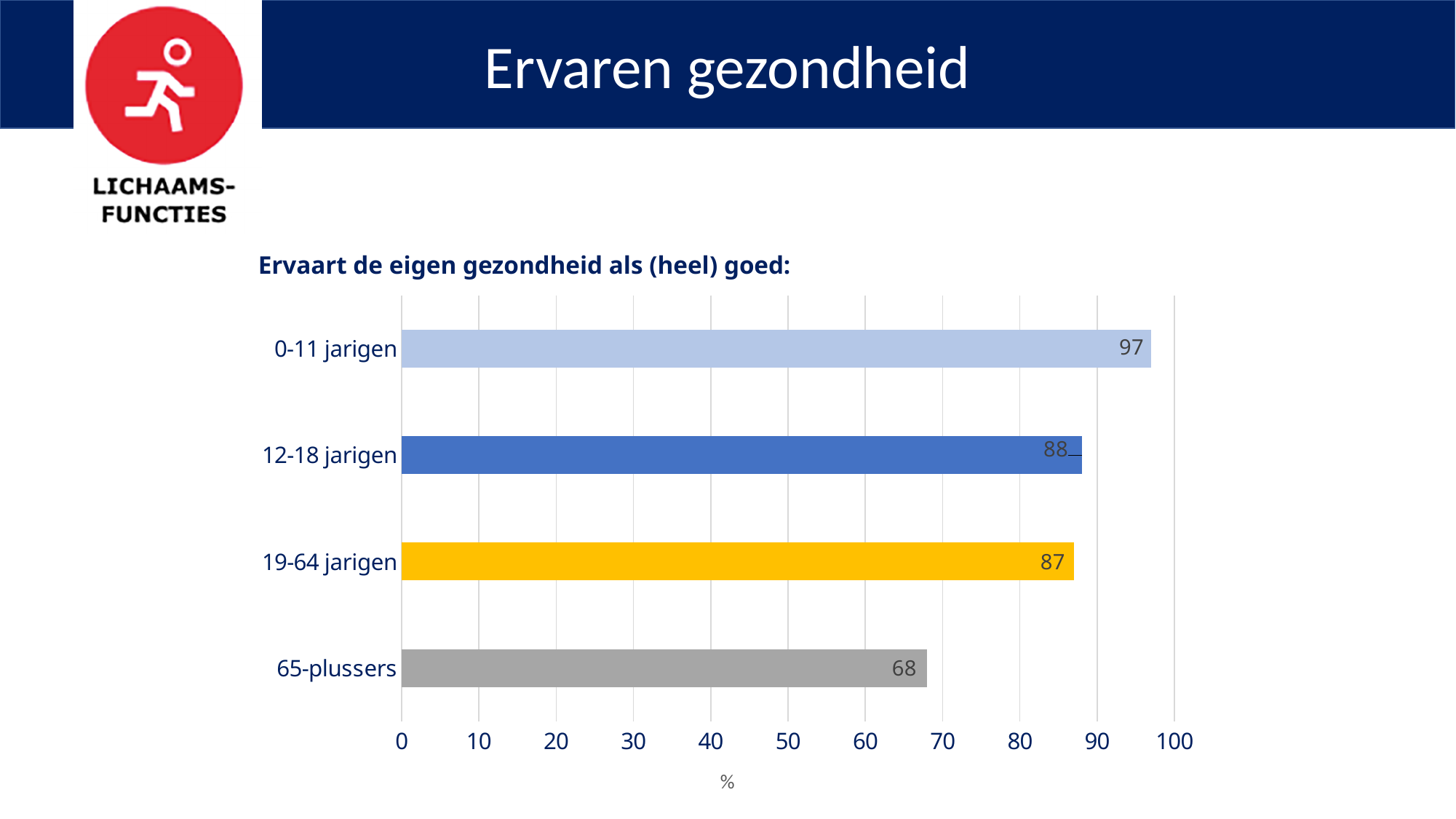
What is the value for 12-18 jarigen? 88 What unit is shown on the horizontal axis of the chart? % Which is larger, the value for 0-11 jarigen or the value for 65-plussers? 0-11 jarigen How many age groups are shown in the chart? 4 What is the difference between the values for 12-18 jarigen and 19-64 jarigen? 1 Which age group has the highest value? 0-11 jarigen What is the difference between the values for 0-11 jarigen and 65-plussers? 29 What is the value for 65-plussers? 68 What kind of chart is shown on the slide? bar chart What is the value for 19-64 jarigen? 87 Which age group has the lowest value? 65-plussers What is the value for 0-11 jarigen? 97